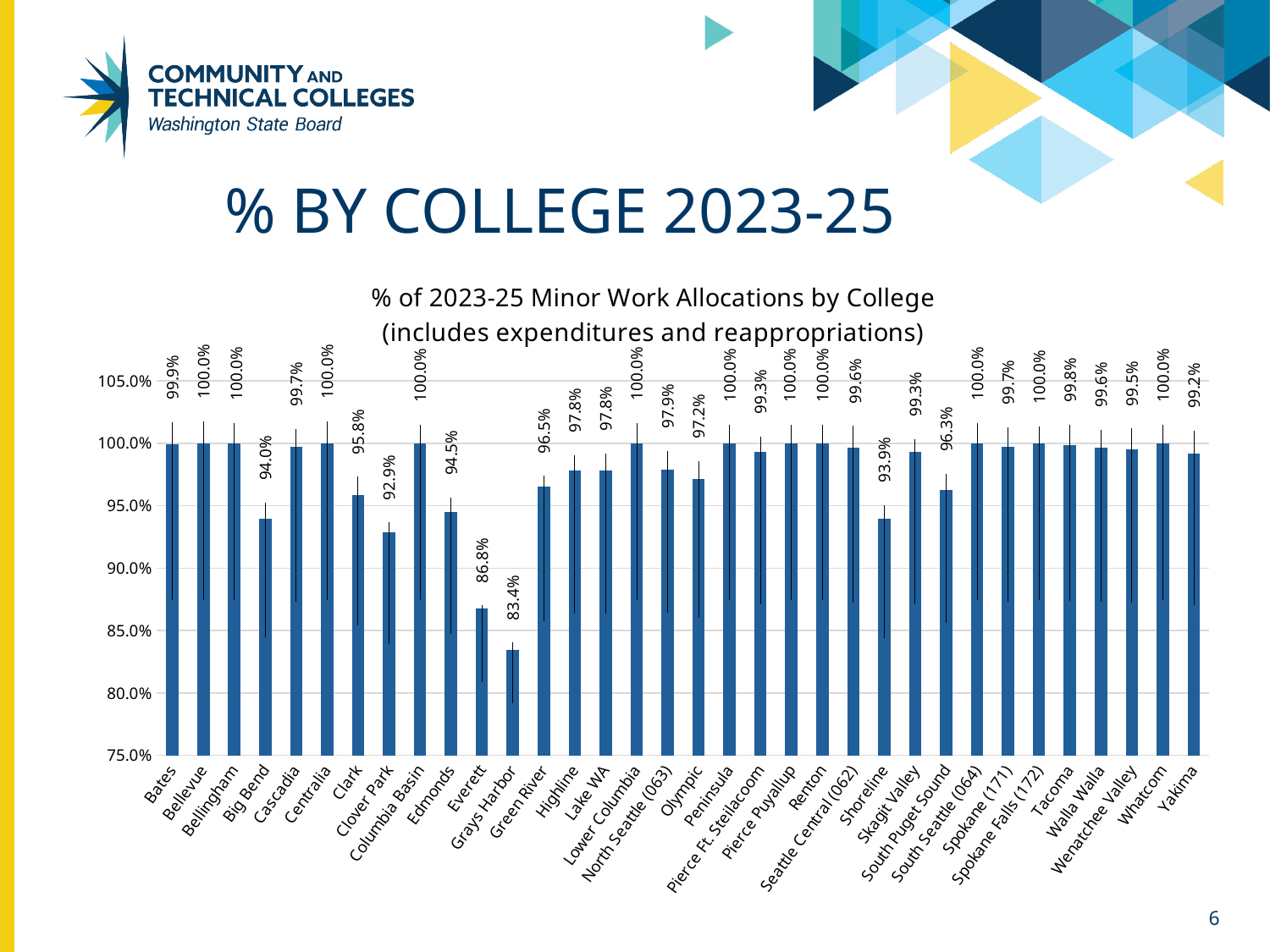
Which college has the lowest value? Grays Harbor What is the difference between the values for Everett and Grays Harbor? 3.4 percentage points Is the value for Everett greater or less than 90.0%? less Which is larger, the value for Edmonds or the value for Big Bend? Edmonds What is the value for Clover Park? 92.9% What is the value for South Puget Sound? 96.3% What is the value for Shoreline? 93.9% What is the value for Grays Harbor? 83.4% What kind of chart is shown on the slide? Bar chart What is the value for Everett? 86.8% How many colleges are shown on the x axis? 34 What is the difference between the values for Clark and Clover Park? 2.9 percentage points